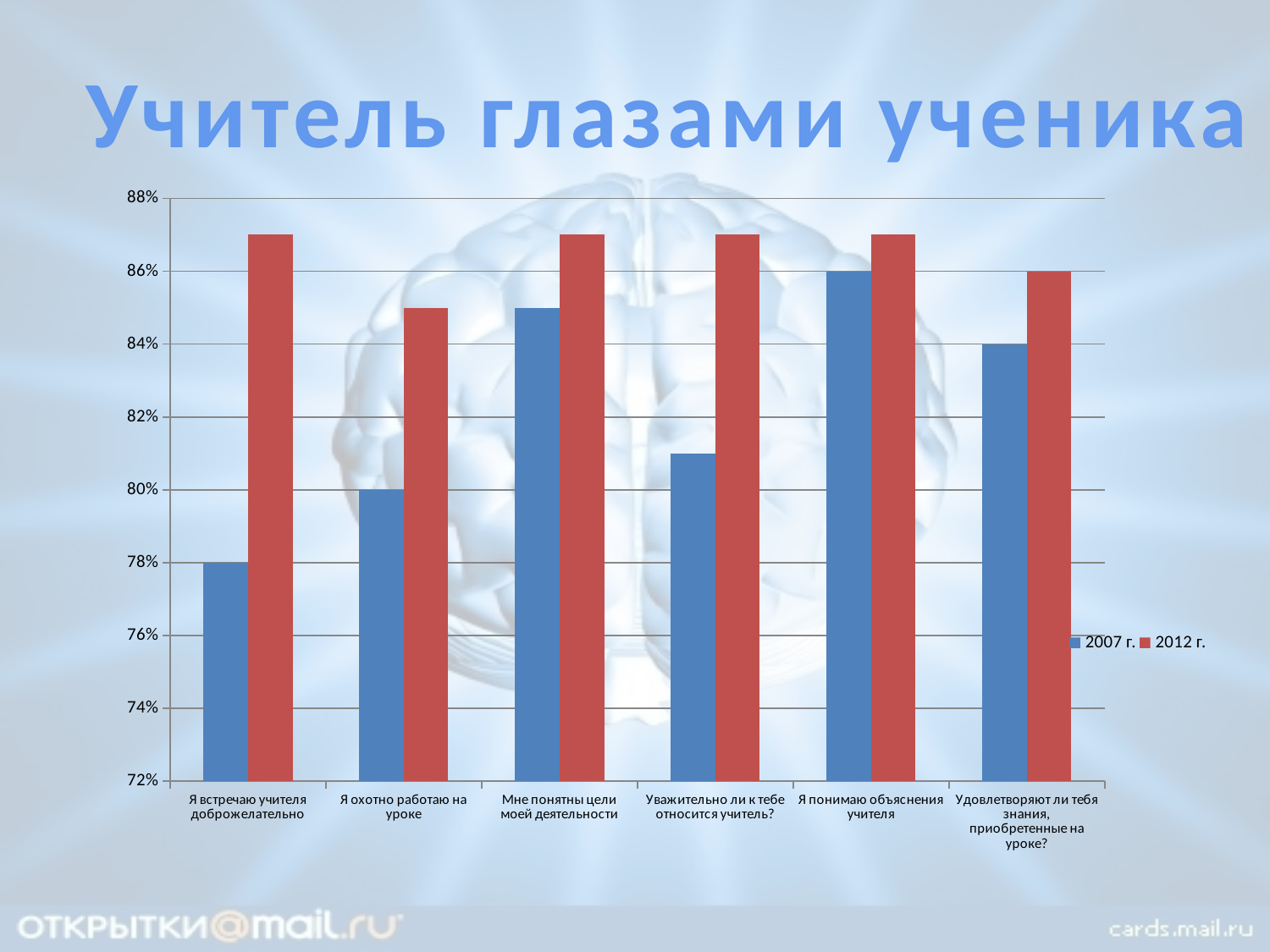
What is the value for 2007 г. in the category "Я встречаю учителя доброжелательно"? 78% How many categories are shown on the x axis? 6 In the category "Я охотно работаю на уроке", which series has the larger value, 2007 г. or 2012 г.? 2012 г. What is the title of the chart on the slide? Учитель глазами ученика What is the value for 2012 г. in the category "Удовлетворяют ли тебя знания, приобретенные на уроке?"? 86% How many series does the legend list? 2 What is the value for 2007 г. in the category "Я охотно работаю на уроке"? 80% Which category has the lowest value for 2007 г.? Я встречаю учителя доброжелательно Is the value for 2012 г. in the category "Я встречаю учителя доброжелательно" greater or less than 86%? greater What is the difference between the 2012 г. and 2007 г. values in the category "Удовлетворяют ли тебя знания, приобретенные на уроке?"? 2% What type of chart is shown on the slide? bar chart Which category has the highest value for 2007 г.? Я понимаю объяснения учителя